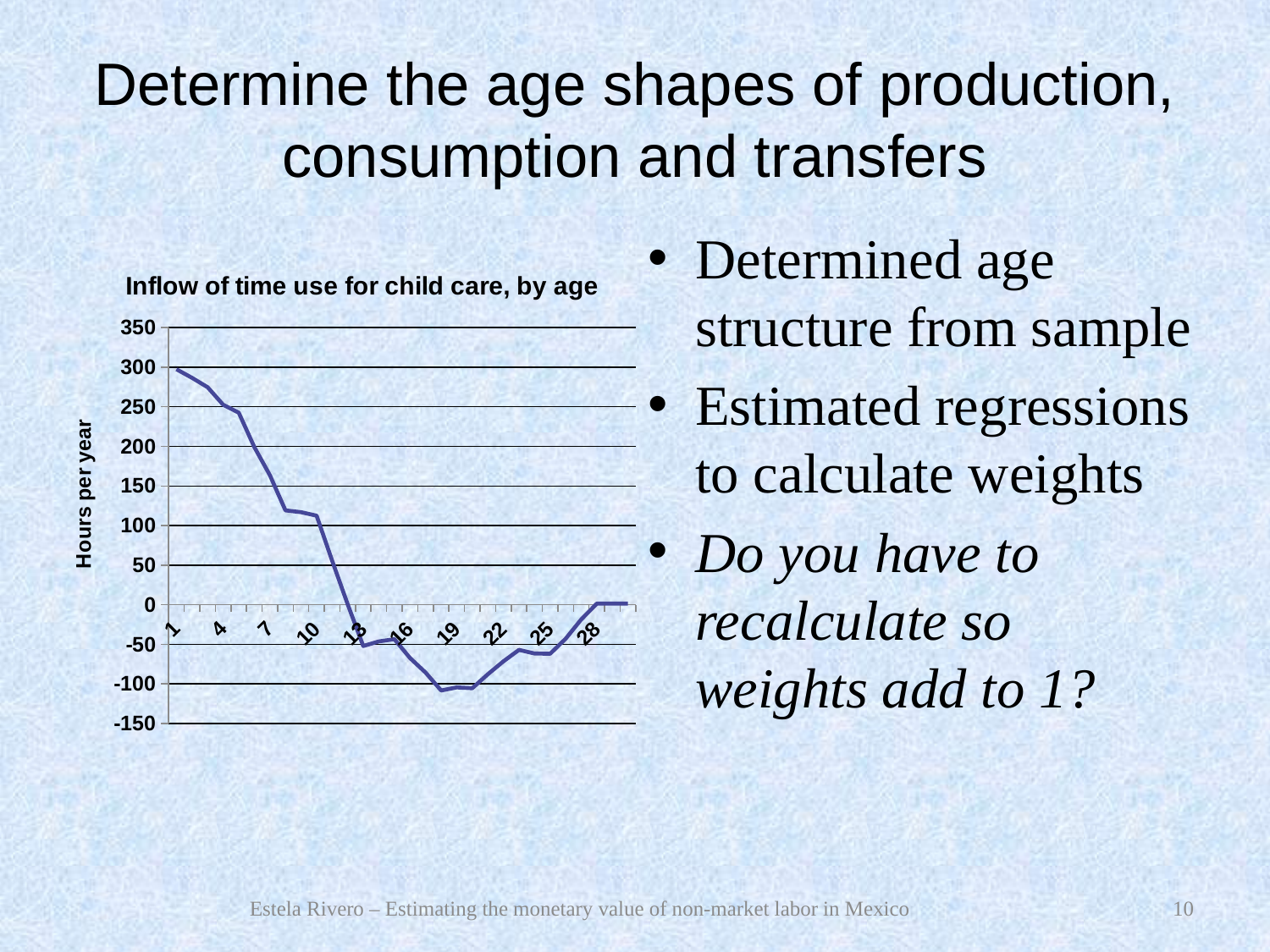
Which age has the highest value on the chart? 1 What is the title of the chart? Inflow of time use for child care, by age Is the value for age 1 greater or less than 250 hours per year? greater Is the value for age 28 greater or less than 50 hours per year? less Which is larger, the value for age 1 or the value for age 19? age 1 Is the value for age 13 greater or less than 0 hours per year? less How many age labels are printed on the x axis? 10 What kind of chart is shown on the slide? line chart What is the label on the vertical axis of the chart? Hours per year Do the values rise or fall along the x axis from age 1 to age 19? fall